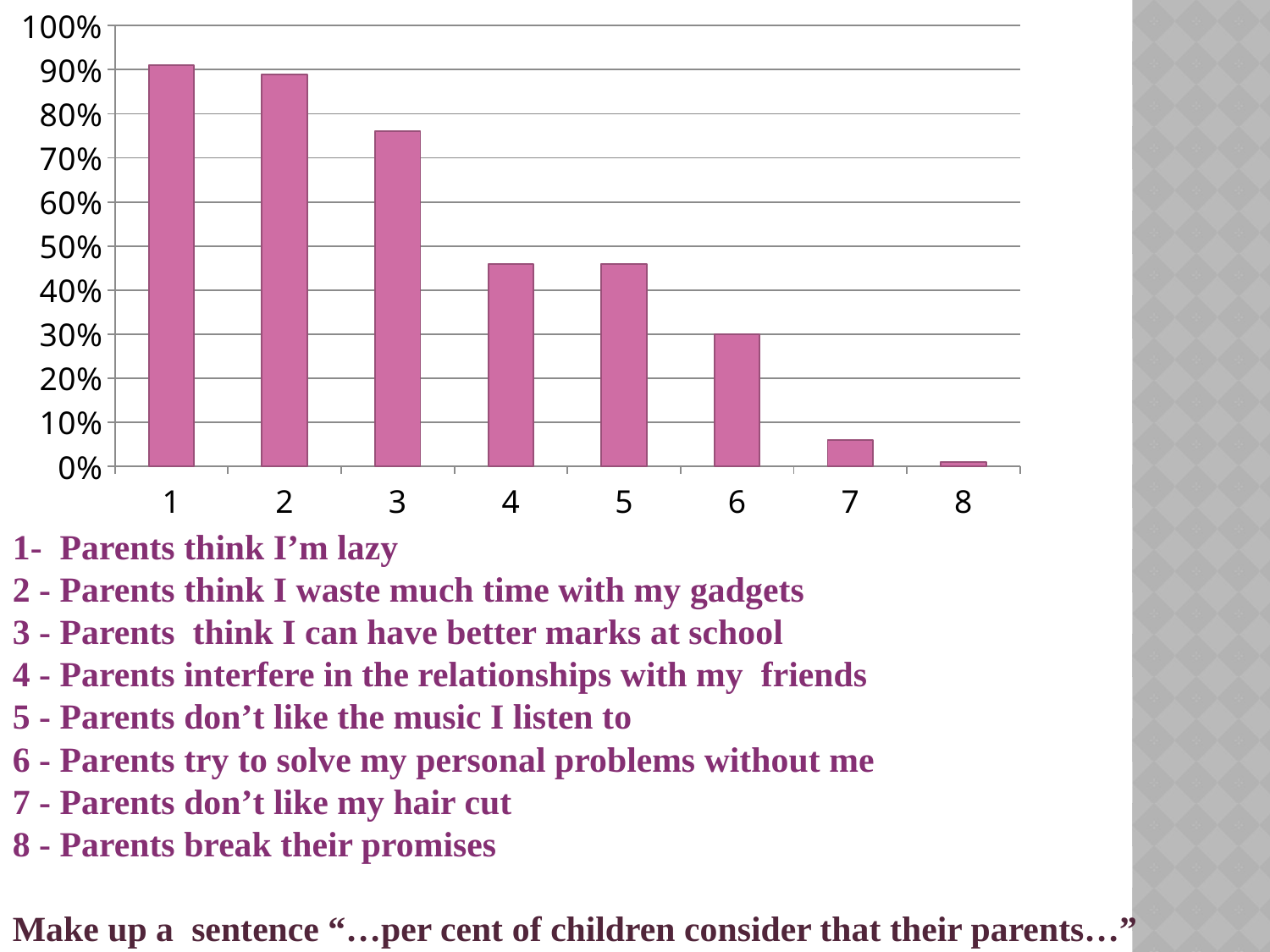
Do the values generally rise or fall from category 1 to category 8? fall Which is larger, the value for category 3 or the value for category 4? category 3 How many categories are plotted on the x axis of the chart? 8 Is the value for category 2 greater or less than 80%? greater What kind of chart is shown on the slide? bar chart Is the value for category 1 greater or less than 90%? greater According to the key below the chart, what does category 8 stand for? Parents break their promises Is the value for category 3 greater or less than 70%? greater Which is larger, the value for category 6 or the value for category 7? category 6 Which category has the lowest value in the chart? 8